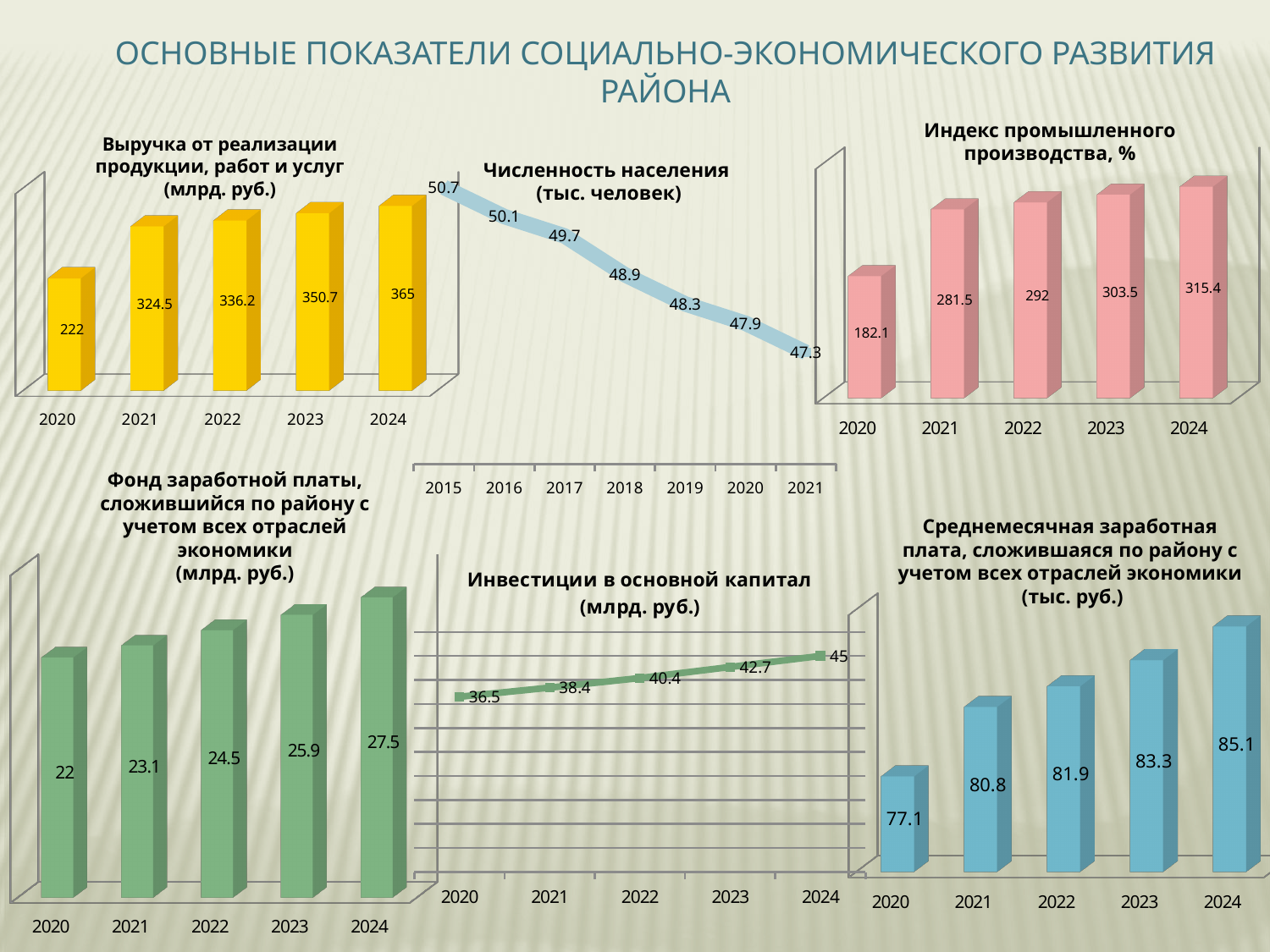
In the chart "Среднемесячная заработная плата, сложившаяся по району с учетом всех отраслей экономики (тыс. руб.)", what is the value for 2020? 77.1 In the chart "Среднемесячная заработная плата, сложившаяся по району с учетом всех отраслей экономики (тыс. руб.)", which is larger, the value for 2022 or the value for 2023? 2023 In the chart "Индекс промышленного производства, %", what is the value for 2022? 292 In the chart "Выручка от реализации продукции, работ и услуг (млрд. руб.)", what is the value for 2021? 324.5 In the chart "Численность населения (тыс. человек)", do the values rise or fall from 2015 to 2021? fall How many data points are plotted in the chart "Численность населения (тыс. человек)"? 7 In the chart "Инвестиции в основной капитал (млрд. руб.)", what is the value for 2023? 42.7 What kind of chart is "Инвестиции в основной капитал (млрд. руб.)"? line chart In the chart "Выручка от реализации продукции, работ и услуг (млрд. руб.)", what is the difference between the 2024 and 2020 values? 143 In the chart "Численность населения (тыс. человек)", what is the value for 2018? 48.9 In the chart "Фонд заработной платы, сложившийся по району с учетом всех отраслей экономики (млрд. руб.)", which year has the highest value? 2024 In the chart "Индекс промышленного производства, %", which year has the lowest value? 2020